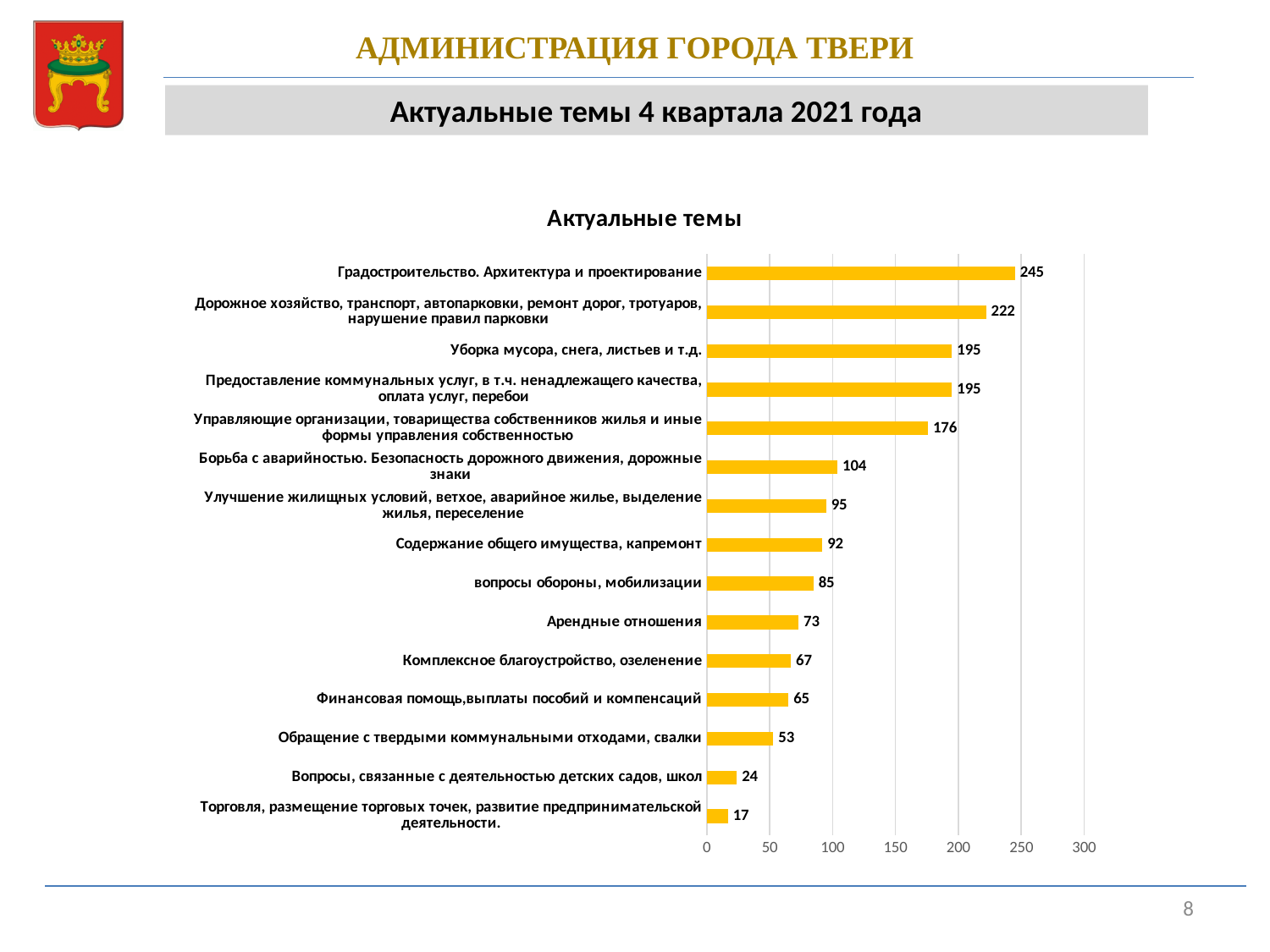
Which category has the lowest value? Торговля, размещение торговых точек, развитие предпринимательской деятельности. What is the value for Градостроительство. Архитектура и проектирование? 245 What is the value for Обращение с твердыми коммунальными отходами, свалки? 53 What is the difference between the values for Вопросы, связанные с деятельностью детских садов, школ and Торговля, размещение торговых точек, развитие предпринимательской деятельности.? 7 What is the difference between the values for Градостроительство. Архитектура и проектирование and Дорожное хозяйство, транспорт, автопарковки, ремонт дорог, тротуаров, нарушение правил парковки? 23 Which category has the highest value? Градостроительство. Архитектура и проектирование What kind of chart is shown on the slide? bar chart What is the value for Арендные отношения? 73 What is the title of the chart? Актуальные темы Which is larger: the value for Содержание общего имущества, капремонт or the value for вопросы обороны, мобилизации? Содержание общего имущества, капремонт How many categories are shown in the chart? 15 Is the value for Управляющие организации, товарищества собственников жилья и иные формы управления собственностью greater or less than 150? greater